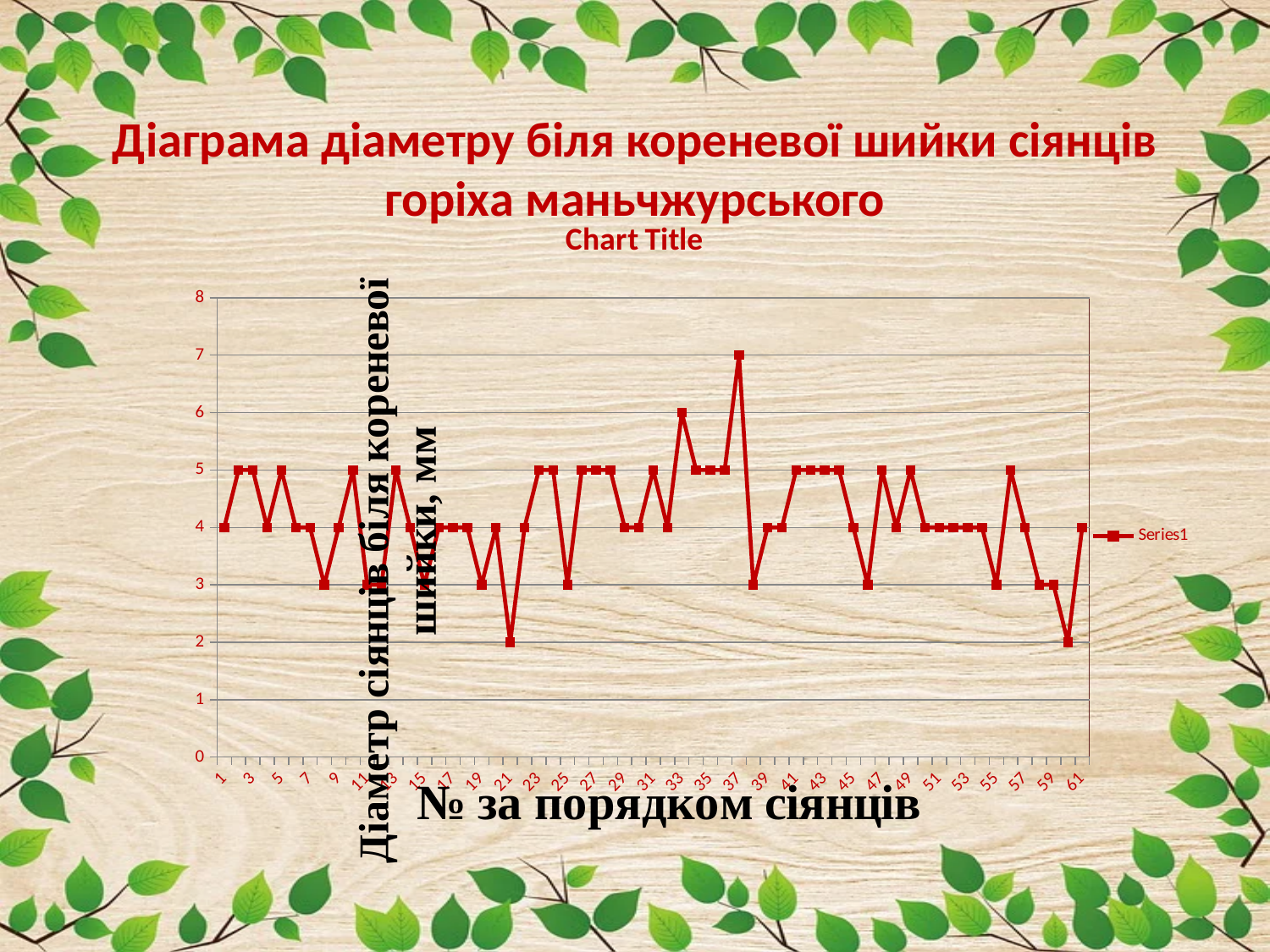
What is the value for seedling number 1? 4 Which has the larger value, seedling 33 or seedling 37? Seedling 37 What is the value for seedling number 33? 6 What is the value for seedling number 37? 7 What is the lowest value plotted on the chart? 2 How many series does the legend list? 1 What kind of chart is shown on the slide? Line chart What is the name of the series shown in the legend? Series1 What is the title of the vertical axis? Діаметр сіянців біля кореневої шийки, мм What is the highest value plotted on the chart? 7 What is the difference between the value for seedling 37 and the value for seedling 21? 5 What is the value for seedling number 21? 2